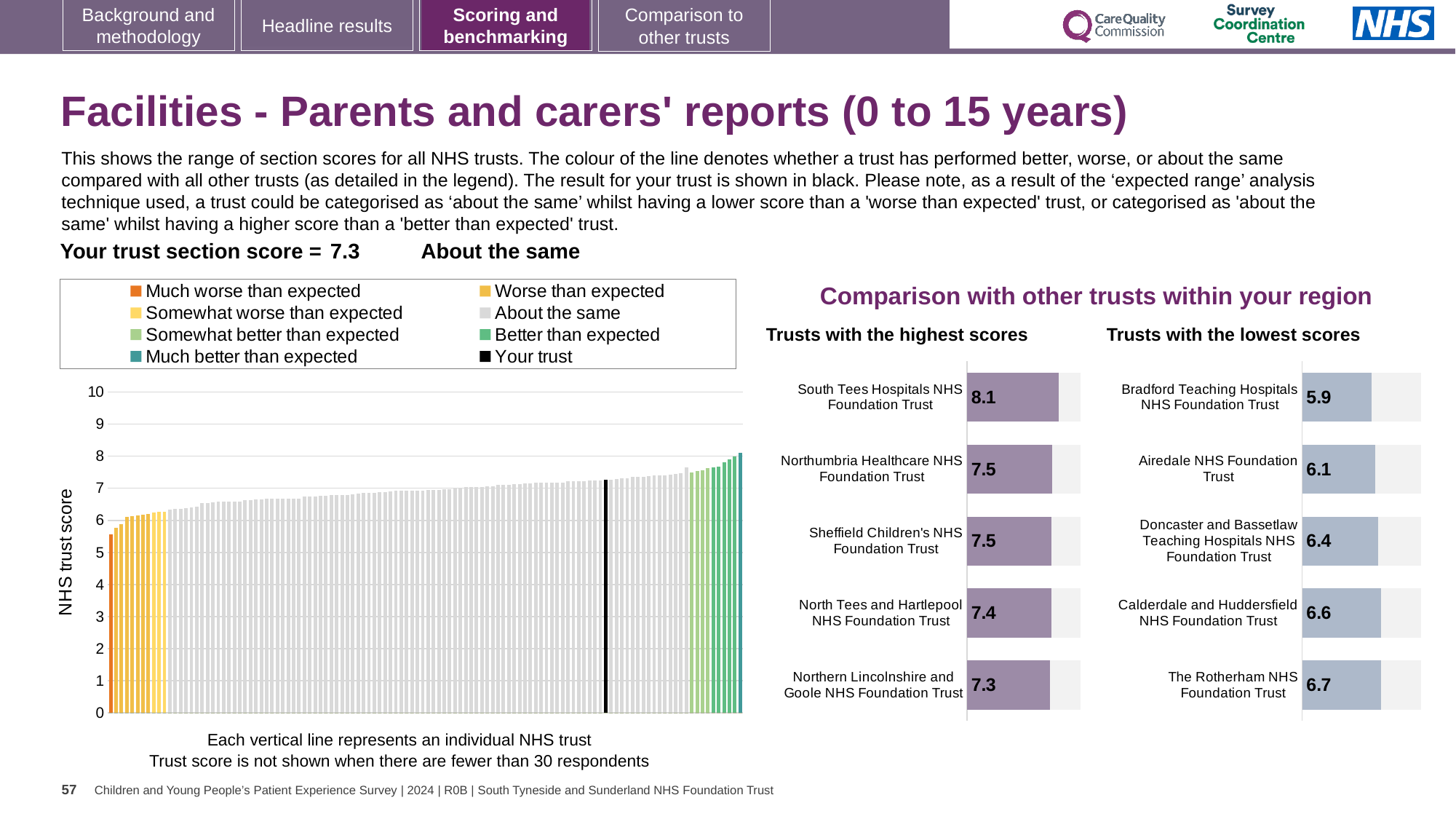
In the 'Trusts with the highest scores' chart, what is the score for North Tees and Hartlepool NHS Foundation Trust? 7.4 In the 'Trusts with the lowest scores' chart, what is the score for Calderdale and Huddersfield NHS Foundation Trust? 6.6 What type of chart is the large chart on the left showing NHS trust scores? Bar chart How many trusts are shown in the 'Trusts with the lowest scores' chart? 5 In the 'Trusts with the highest scores' chart, what is the score for South Tees Hospitals NHS Foundation Trust? 8.1 In the 'Trusts with the lowest scores' chart, which has the higher score: Airedale NHS Foundation Trust or Doncaster and Bassetlaw Teaching Hospitals NHS Foundation Trust? Doncaster and Bassetlaw Teaching Hospitals NHS Foundation Trust How many entries does the legend of the large chart on the left list? 8 In the 'Trusts with the lowest scores' chart, which trust has the lowest score? Bradford Teaching Hospitals NHS Foundation Trust In the 'Trusts with the highest scores' chart, what is the difference between the scores of South Tees Hospitals NHS Foundation Trust and Northern Lincolnshire and Goole NHS Foundation Trust? 0.8 In the 'Trusts with the lowest scores' chart, what is the score for Bradford Teaching Hospitals NHS Foundation Trust? 5.9 In the 'Trusts with the highest scores' chart, which trust has the highest score? South Tees Hospitals NHS Foundation Trust In the large chart on the left, is the score for the lowest-scoring trust (the leftmost bar) greater or less than 6? less